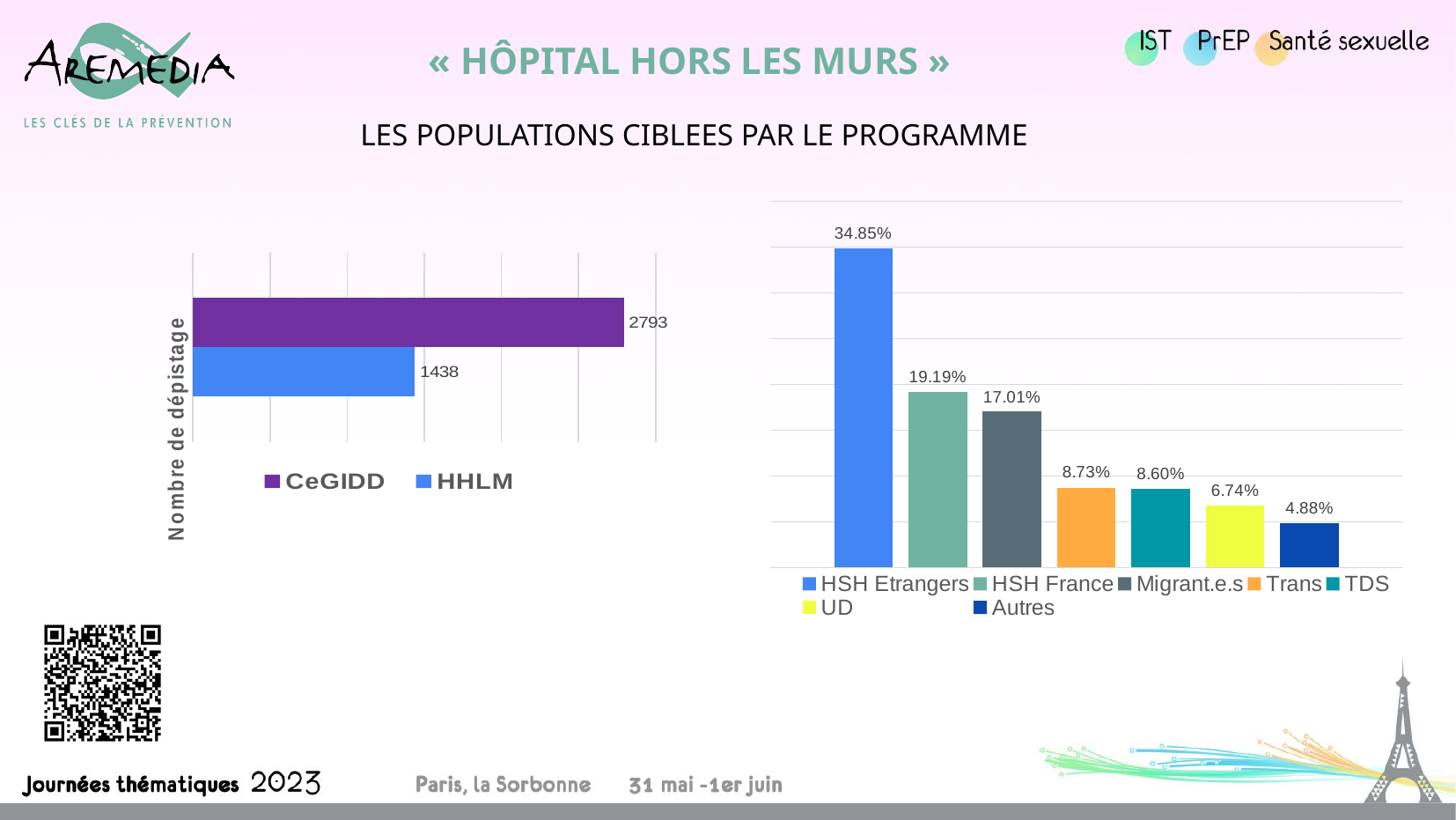
In the left chart (Nombre de dépistage), what is the value for HHLM? 1438 In the right chart, which category has the lowest value? Autres What kind of chart is the left chart (Nombre de dépistage)? Bar chart In the right chart, what is the value for HSH Etrangers? 34.85% In the left chart (Nombre de dépistage), what is the difference between the CeGIDD and HHLM values? 1355 In the right chart, which category has the highest value? HSH Etrangers In the left chart (Nombre de dépistage), which is larger, CeGIDD or HHLM? CeGIDD In the right chart, what is the difference between HSH France and HSH Etrangers? 15.66% How many categories does the legend of the right chart list? 7 In the right chart, what is the value for UD? 6.74% In the right chart, what is the value for Migrant.e.s? 17.01% In the left chart (Nombre de dépistage), what is the value for CeGIDD? 2793